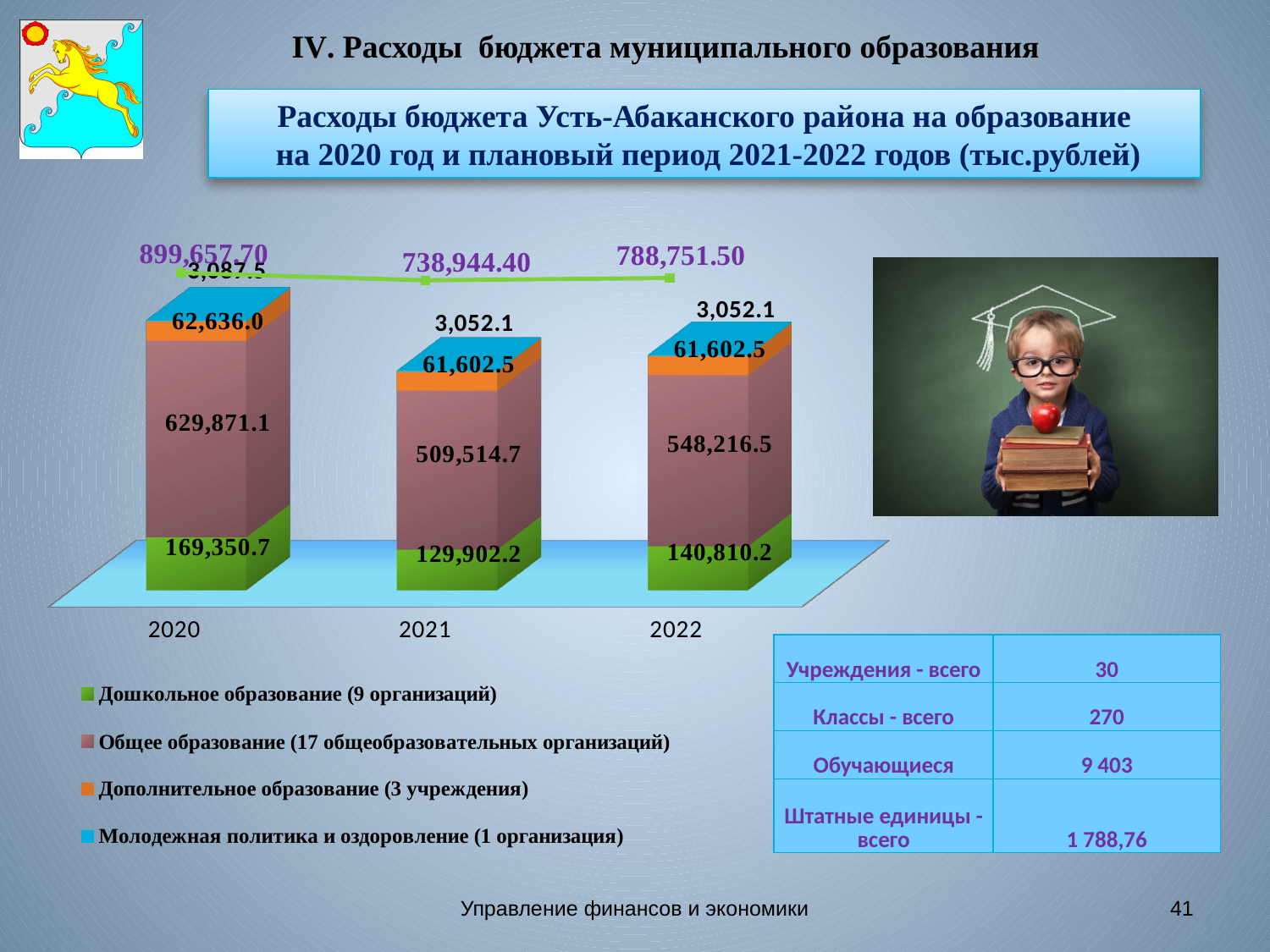
What is the difference between the Общее образование values for 2022 and 2021? 38,701.8 What is the total shown above the bar for 2021? 738,944.40 What is the value for Дополнительное образование in 2022? 61,602.5 What is the value for Общее образование in 2020? 629,871.1 Which year has the highest total expenditure on education? 2020 Which year has the lowest total expenditure on education? 2021 What kind of chart is shown on the slide? stacked bar chart How many series does the chart legend list? 4 What is the value for Молодежная политика и оздоровление in 2022? 3,052.1 Which is larger: Дошкольное образование in 2020 or in 2022? 2020 How many years are shown on the x axis of the chart? 3 What is the value for Дошкольное образование in 2021? 129,902.2